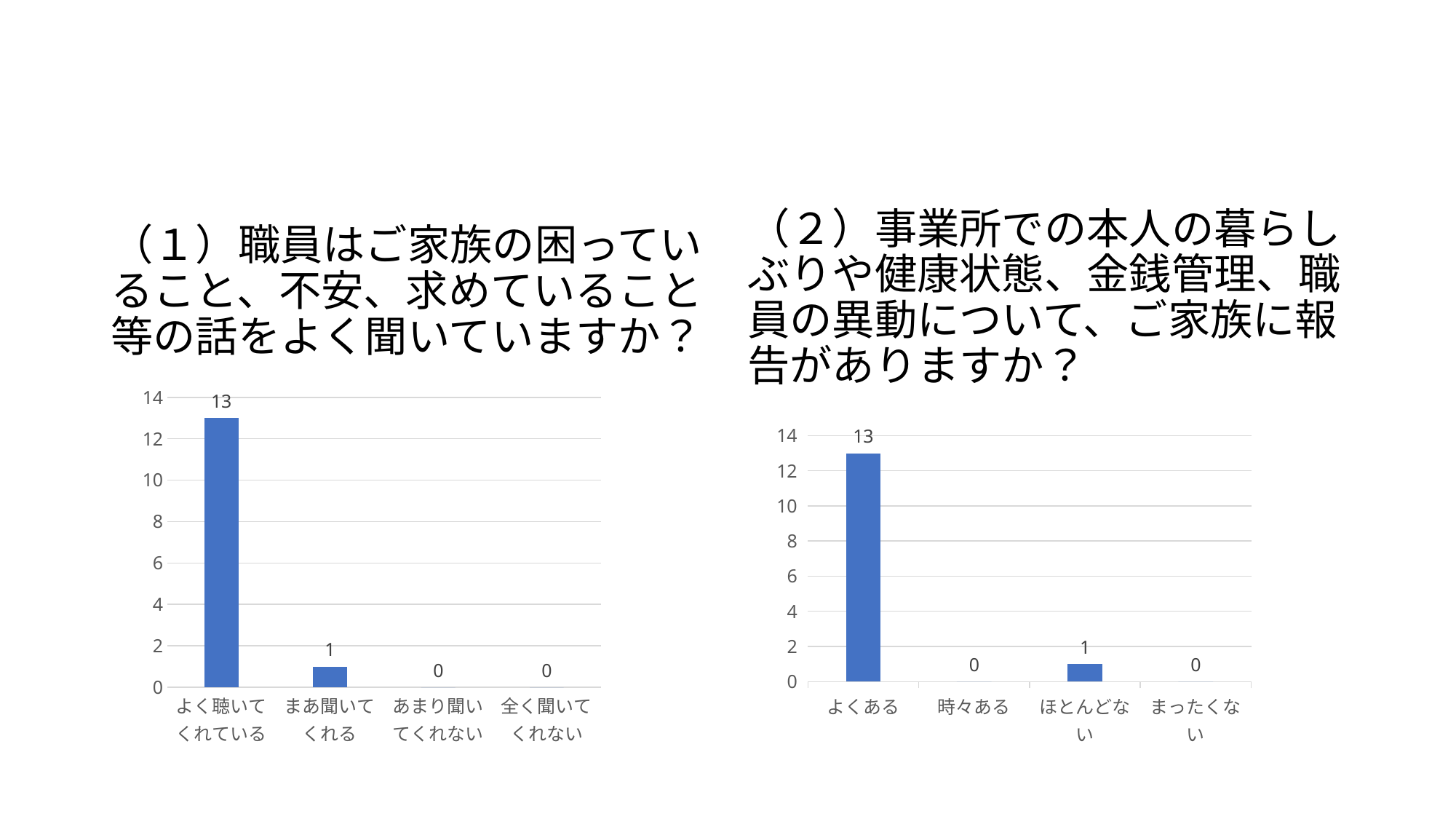
In the left chart (1), which category has the highest value? よく聴いてくれている In the right chart (2), is the value for よくある greater or less than 10? greater In the left chart (1), what is the difference between よく聴いてくれている and まあ聞いてくれる? 12 In the right chart (2), what is the value for よくある? 13 What type of chart is the right chart (2)? bar chart In the right chart (2), which is larger, よくある or ほとんどない? よくある In the left chart (1), what is the value for よく聴いてくれている? 13 In the right chart (2), what is the value for ほとんどない? 1 In the left chart (1), how many categories are shown on the x axis? 4 In the left chart (1), what is the total of all four values? 14 In the right chart (2), what is the value for 時々ある? 0 In the left chart (1), what is the value for まあ聞いてくれる? 1